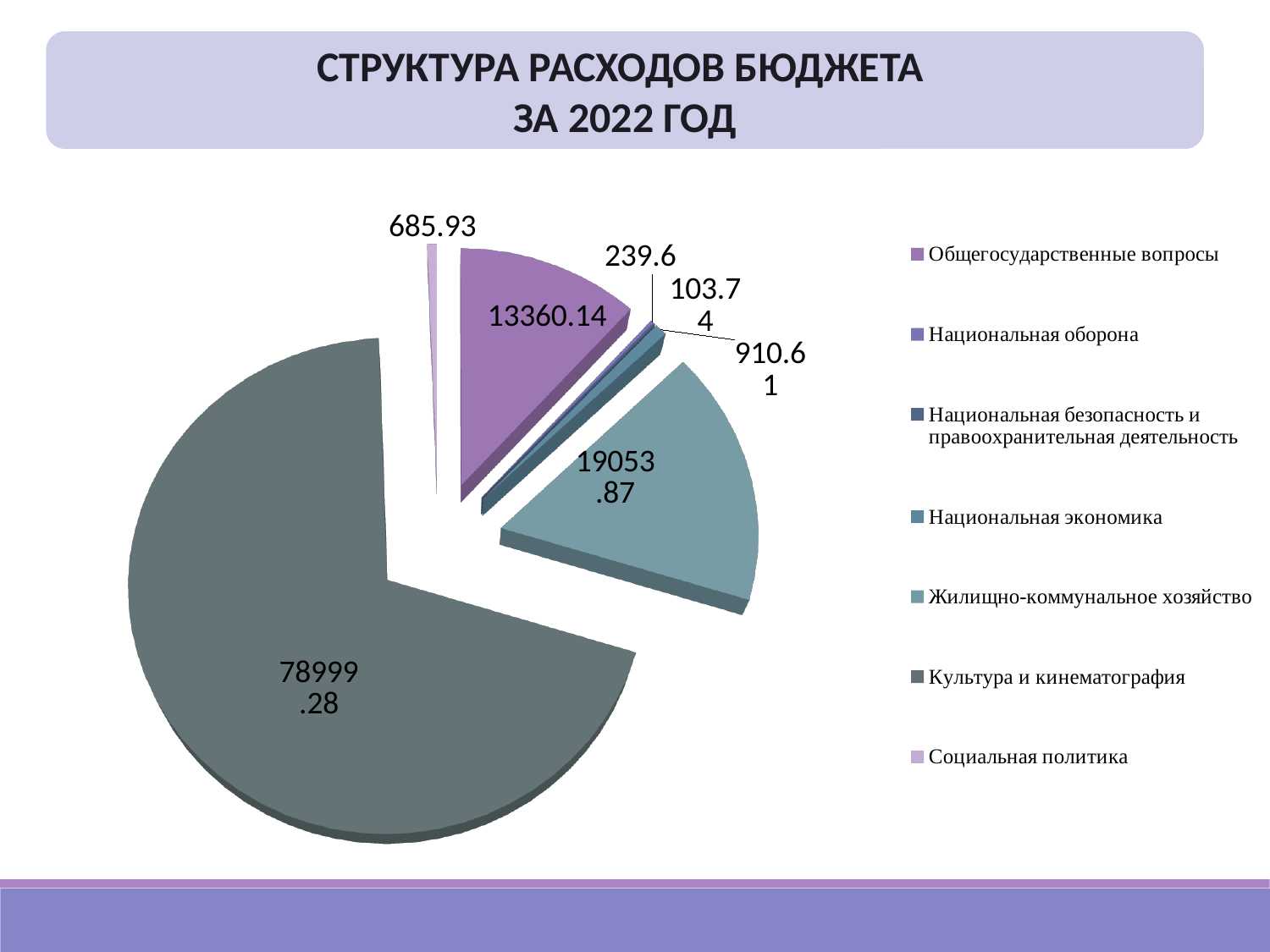
Which is larger: the value for Национальная экономика or the value for Социальная политика? Национальная экономика Which category has the largest slice of the pie? Культура и кинематография Which category has the smallest value? Национальная безопасность и правоохранительная деятельность What type of chart is shown on the slide? Pie chart What is the value for Жилищно-коммунальное хозяйство? 19053.87 What is the title of the chart on the slide? СТРУКТУРА РАСХОДОВ БЮДЖЕТА ЗА 2022 ГОД What is the value for Национальная безопасность и правоохранительная деятельность? 103.74 What is the value for Культура и кинематография? 78999.28 How many categories does the legend list? 7 What is the difference between the values for Жилищно-коммунальное хозяйство and Общегосударственные вопросы? 5693.73 What is the value for Социальная политика? 685.93 What is the value for Общегосударственные вопросы? 13360.14